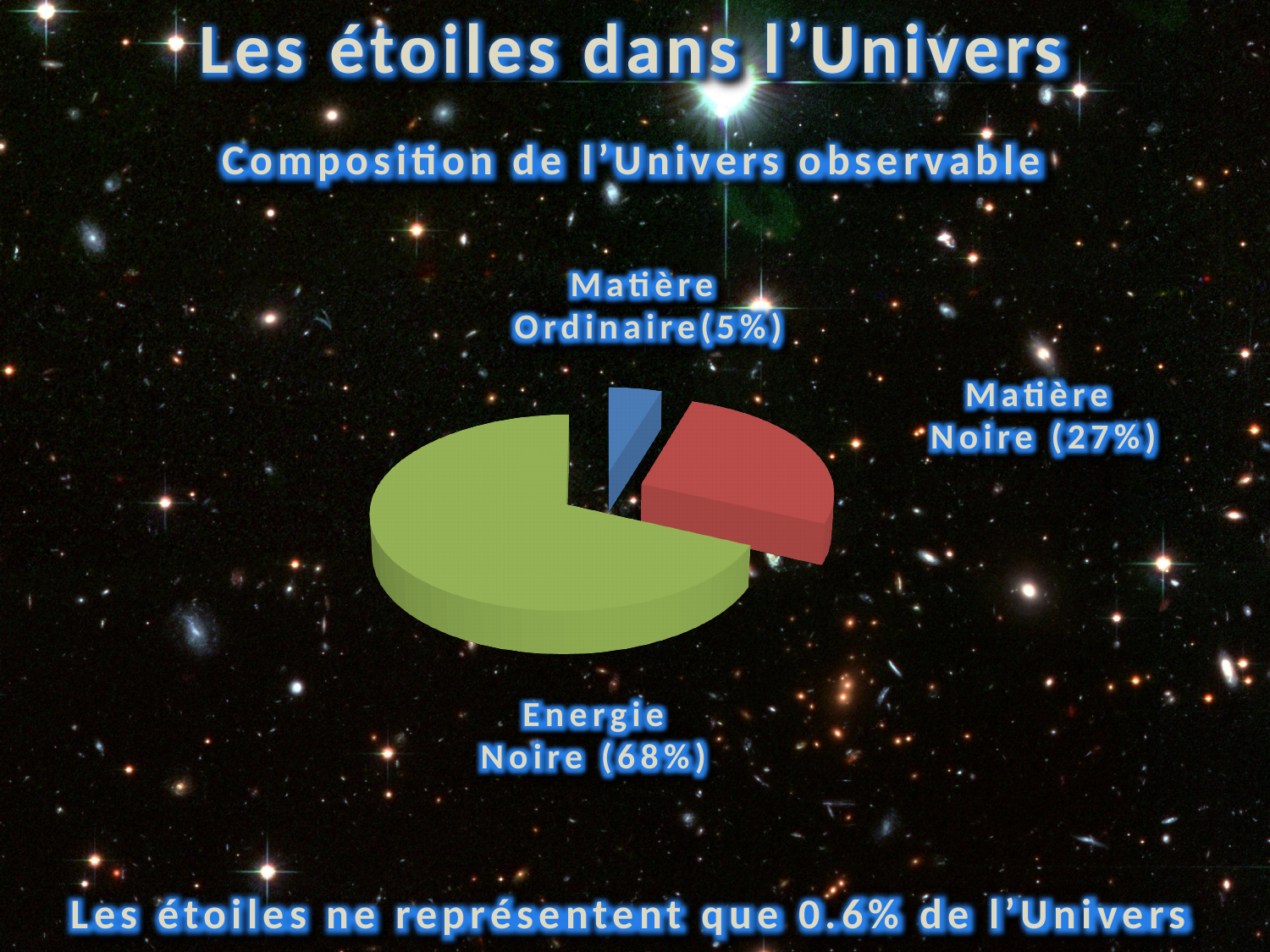
What is the difference in percentage points between Matière Noire and Matière Ordinaire? 22 What is the title of the pie chart? Composition de l'Univers observable Which component has the smallest slice of the pie? Matière Ordinaire What share of the observable Universe is Energie Noire? 68% How many slices does the pie chart have? 3 What colour is the Energie Noire slice? green What kind of chart is shown on the slide? pie chart Which component has the largest slice of the pie? Energie Noire What share of the observable Universe is Matière Noire? 27% What is the difference in percentage points between Energie Noire and Matière Noire? 41 Which is larger, the share of Matière Noire or the share of Matière Ordinaire? Matière Noire What share of the observable Universe is Matière Ordinaire? 5%